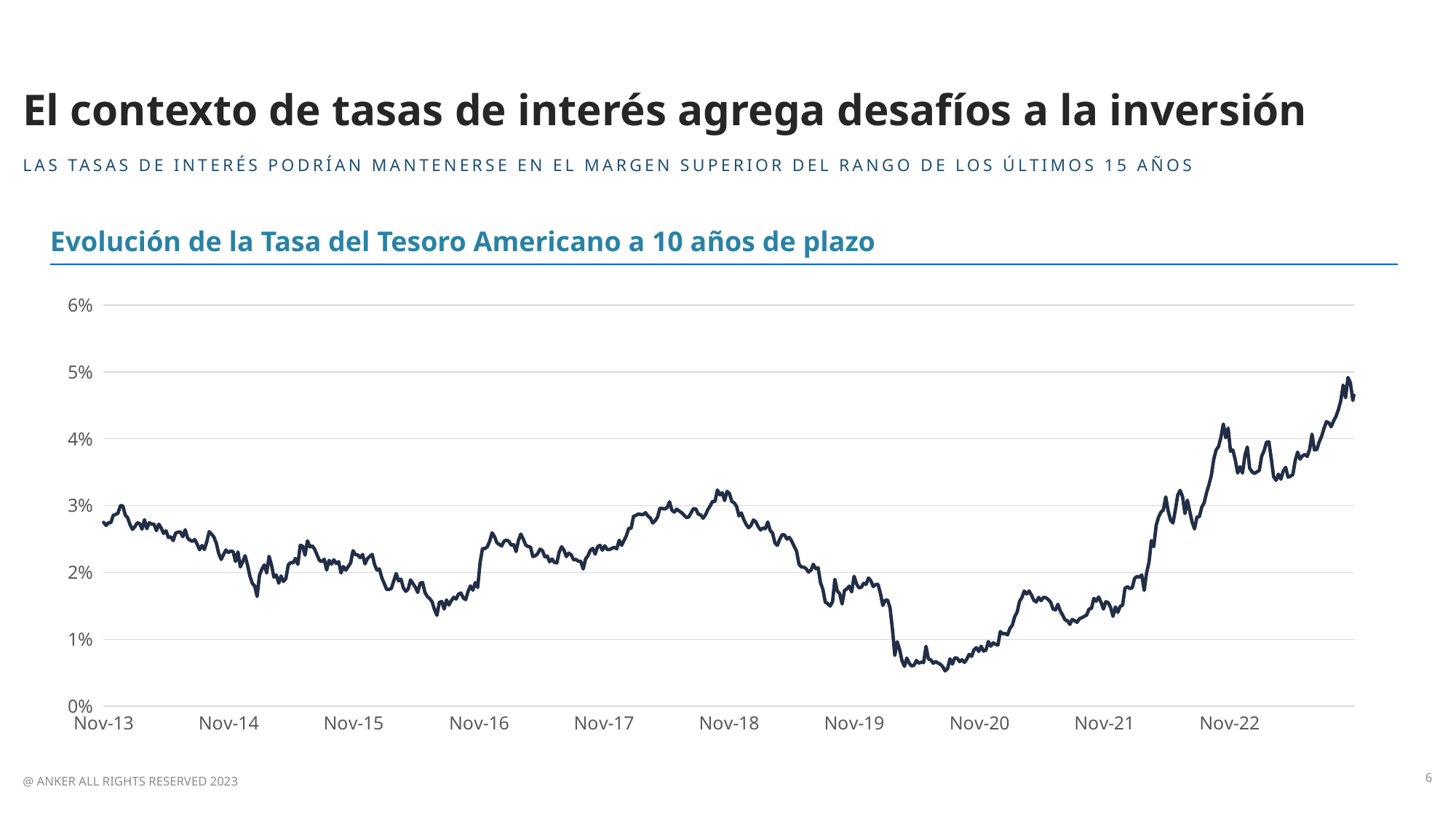
What is the title of the chart? Evolución de la Tasa del Tesoro Americano a 10 años de plazo What kind of chart is shown on the slide? line chart How many date labels are shown on the x axis of the chart? 10 Is the lowest point of the line greater or less than 1%? less How many lines are plotted on the chart? 1 Does the line rise or fall between Nov-18 and Nov-20? fall Is the value at Nov-13 greater or less than 2%? greater Is the value at Nov-21 greater or less than 2%? less Does the line rise or fall between Nov-21 and the end of the series? rise